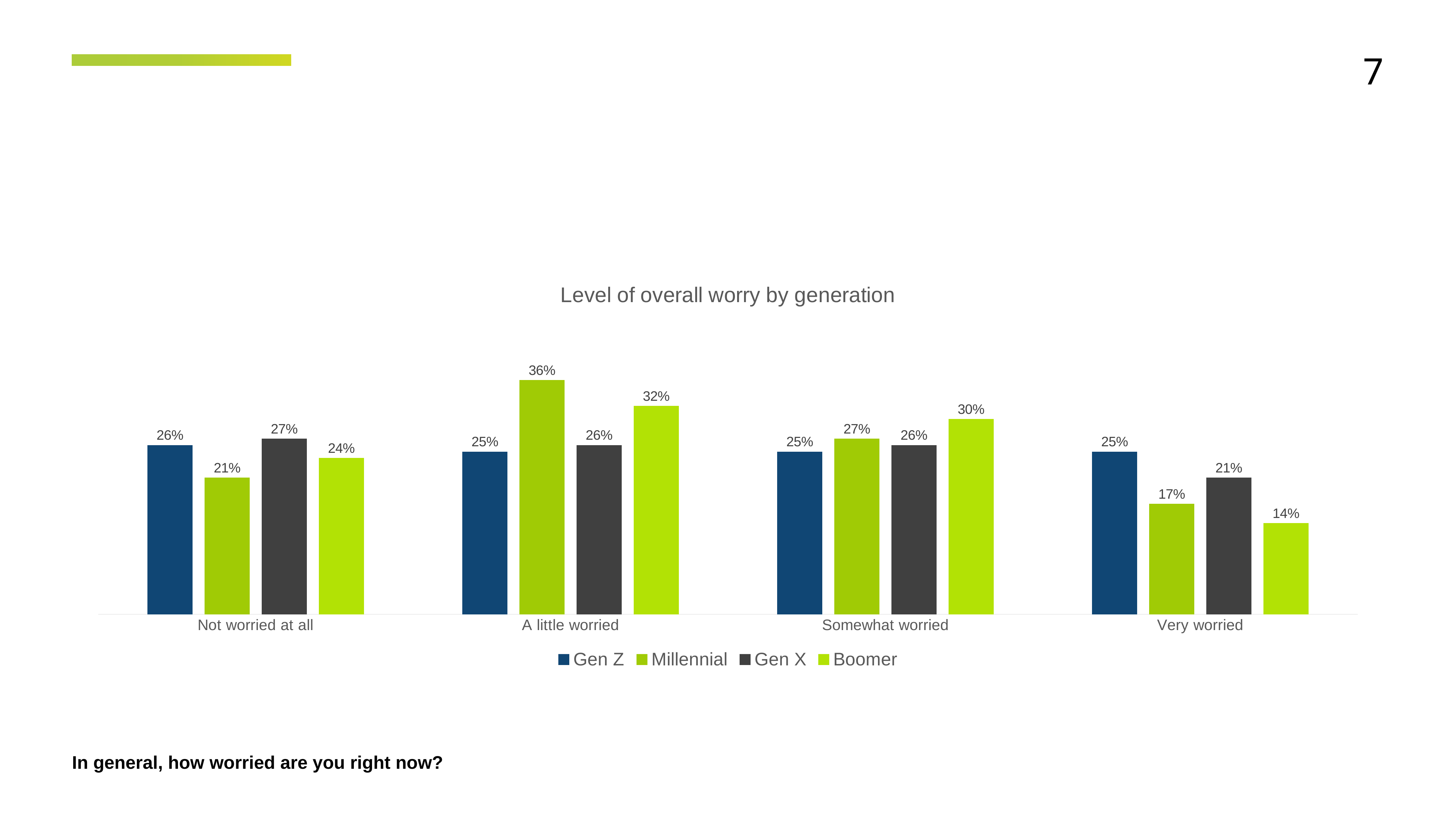
What kind of chart is shown on the slide? Bar chart What is the value for Boomer in the 'Very worried' category? 14% What is the difference between the Millennial and Gen Z values in the 'A little worried' category? 11% Which generation has the lowest value in the 'Very worried' category? Boomer What is the value for Gen X in the 'Not worried at all' category? 27% How many categories are shown on the x axis? 4 Which generation has the highest value in the 'A little worried' category? Millennial What is the value for Millennial in the 'A little worried' category? 36% What is the title of the chart? Level of overall worry by generation How many series does the legend list? 4 What is the difference between the Gen Z and Boomer values in the 'Very worried' category? 11% Which is larger in the 'Somewhat worried' category: the Boomer value or the Gen Z value? Boomer